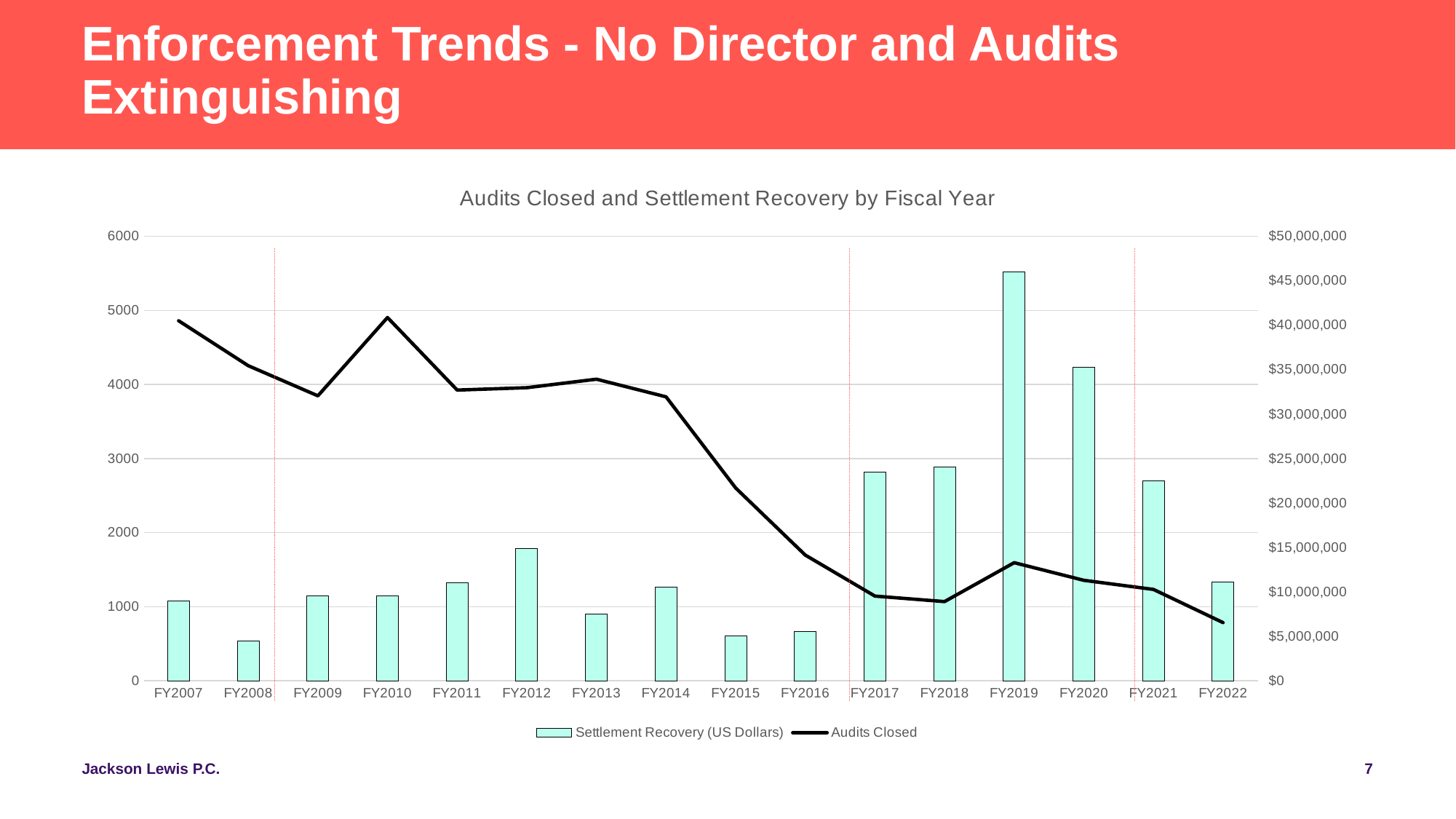
Is the Audits Closed value for FY2007 greater or less than 4000? greater How many fiscal years are shown on the x axis? 16 Is the Settlement Recovery for FY2019 greater or less than $40,000,000? greater What kind of chart is this? A combined bar and line chart Which fiscal year has the highest Settlement Recovery (US Dollars)? FY2019 Which fiscal year has the lowest Audits Closed value? FY2022 Does the Audits Closed line generally rise or fall from FY2007 to FY2022? fall Which has the larger Settlement Recovery, FY2019 or FY2020? FY2019 Is the Audits Closed value for FY2022 greater or less than 1000? less How many series does the legend list? 2 What is the title of the chart? Audits Closed and Settlement Recovery by Fiscal Year